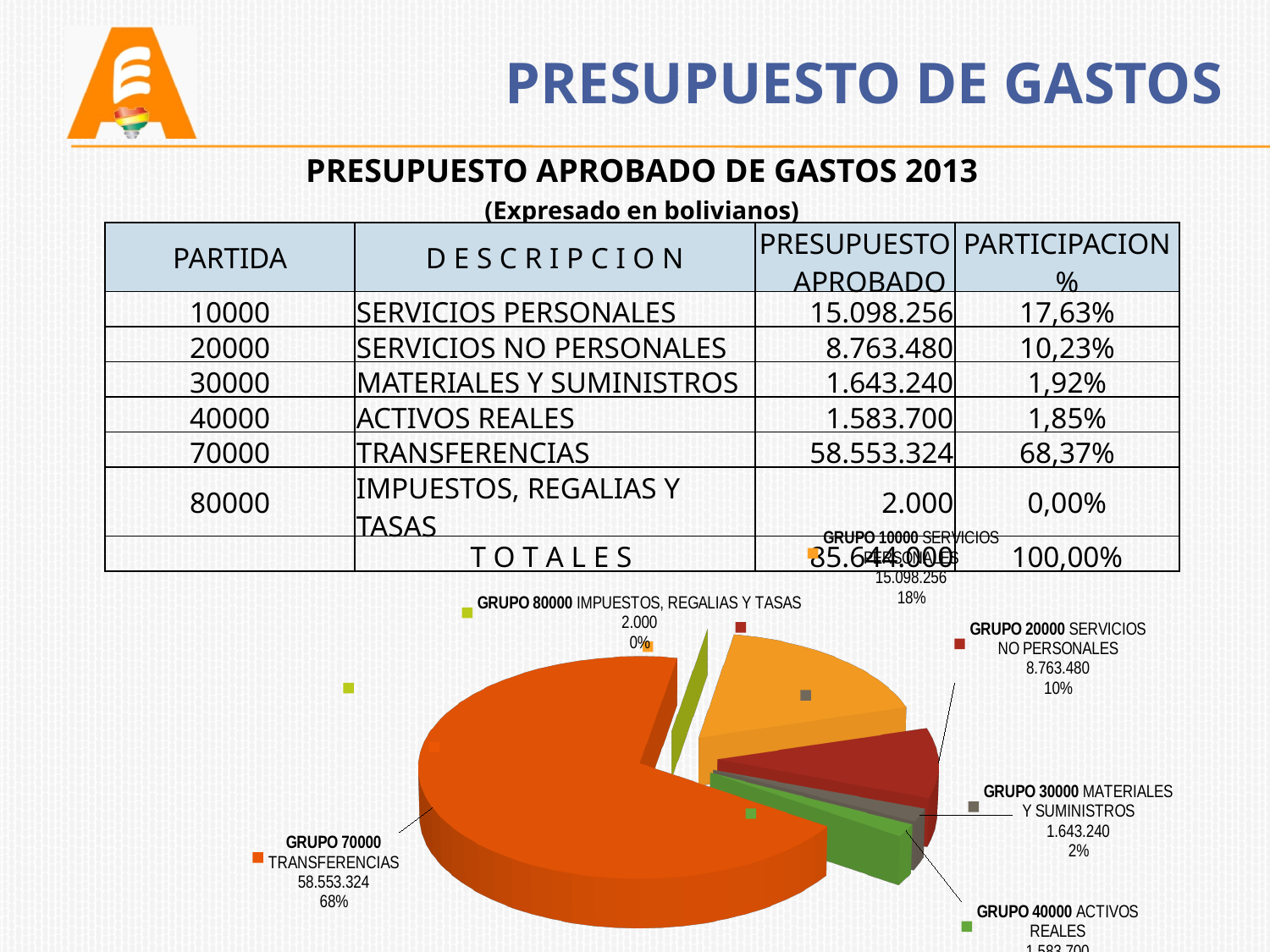
Which group has the largest slice in the pie chart? GRUPO 70000 TRANSFERENCIAS In the pie chart, which is larger: GRUPO 20000 SERVICIOS NO PERSONALES or GRUPO 30000 MATERIALES Y SUMINISTROS? GRUPO 20000 SERVICIOS NO PERSONALES What value is shown on the pie chart for GRUPO 20000 SERVICIOS NO PERSONALES? 8.763.480 How many slices does the pie chart have? 6 Which group has the smallest slice in the pie chart? GRUPO 80000 IMPUESTOS, REGALIAS Y TASAS What percentage share does the pie chart show for GRUPO 70000 TRANSFERENCIAS? 68% What value is shown on the pie chart for GRUPO 70000 TRANSFERENCIAS? 58.553.324 What kind of chart is shown on the slide? pie chart What percentage share does the pie chart show for GRUPO 20000 SERVICIOS NO PERSONALES? 10% What value is shown on the pie chart for GRUPO 30000 MATERIALES Y SUMINISTROS? 1.643.240 What percentage share does the pie chart show for GRUPO 80000 IMPUESTOS, REGALIAS Y TASAS? 0% What is the difference between the values shown for GRUPO 30000 MATERIALES Y SUMINISTROS and GRUPO 40000 ACTIVOS REALES in the pie chart? 59.540